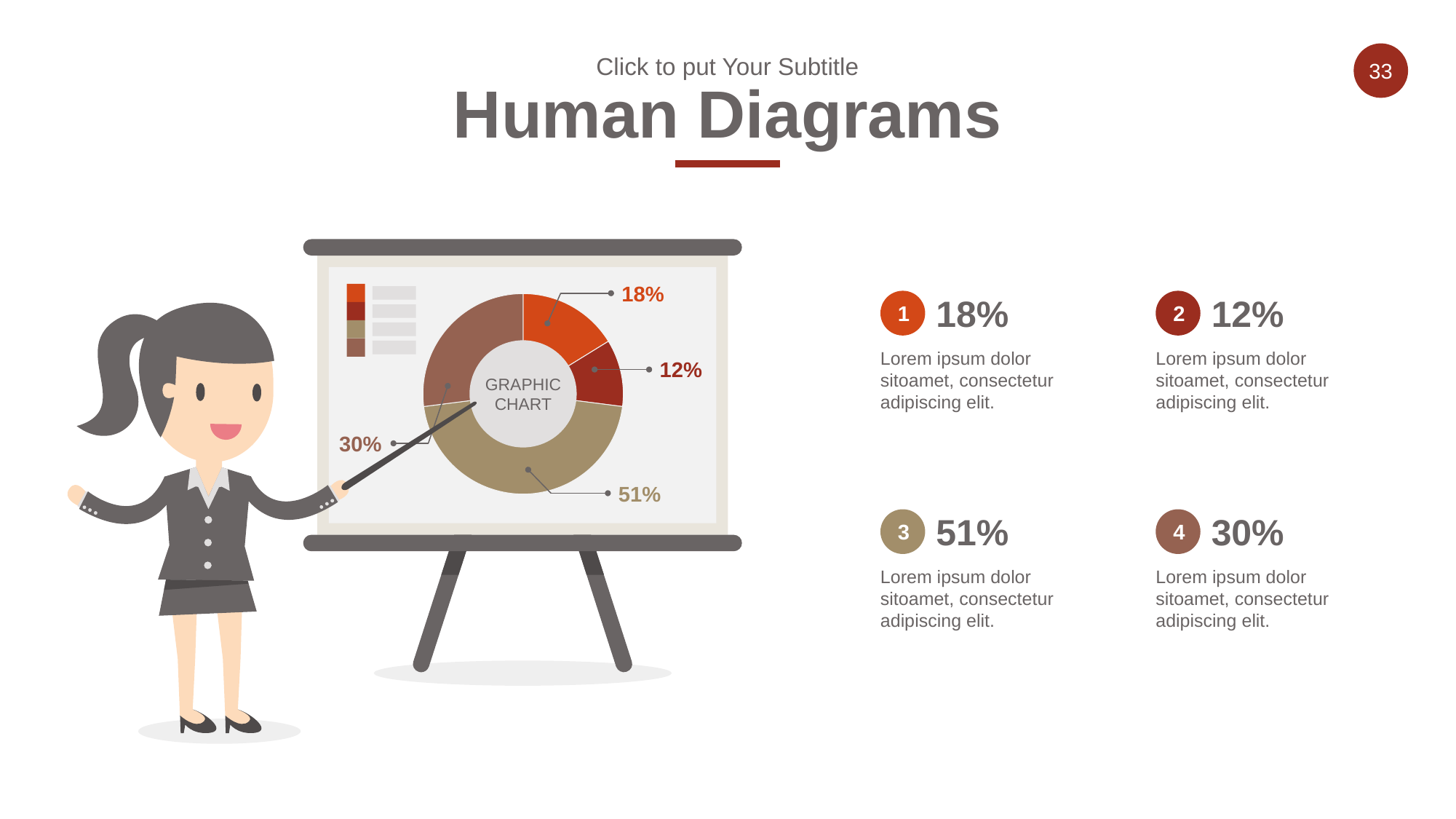
What kind of chart is shown on the presentation board? Donut (pie) chart Which is larger in the donut chart, the orange slice or the dark red slice? The orange slice (18%) What percentage is listed next to item 4 in the text on the right of the slide? 30% What value is labelled on the tan (khaki) slice of the donut chart? 51% What text is written in the centre of the donut chart? GRAPHIC CHART What value is labelled on the brown slice of the donut chart? 30% How many slices does the donut chart have? 4 Which slice of the donut chart has the smallest value? 12% What value is labelled on the orange slice of the donut chart? 18% What value is labelled on the dark red slice of the donut chart? 12% Which slice of the donut chart has the largest value? 51% What is the difference between the largest slice (51%) and the smallest slice (12%) of the donut chart? 39%